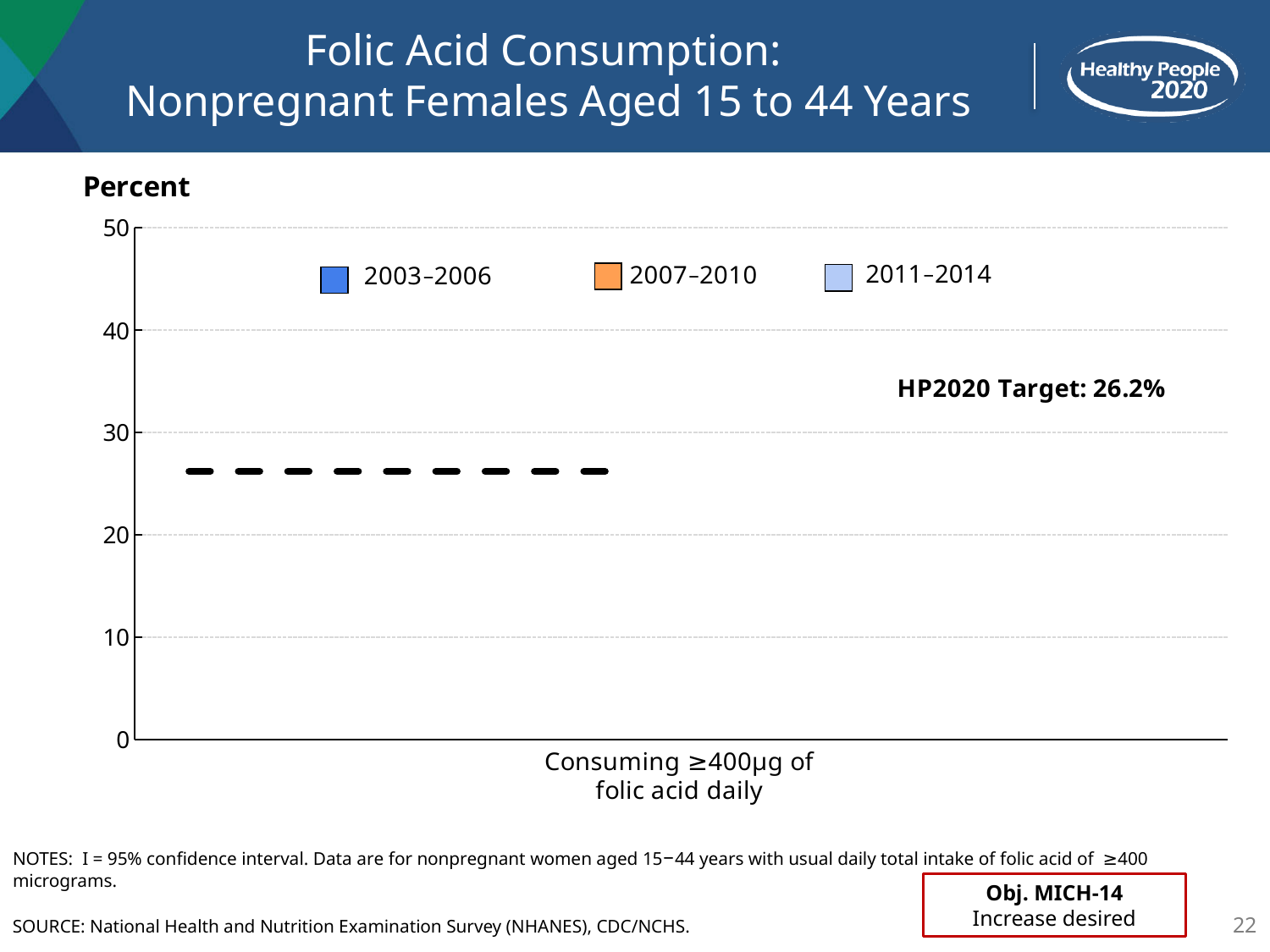
What is the maximum value shown on the y axis? 50 Is the HP2020 Target line greater or less than 20? greater What is the HP2020 Target value shown on the chart? 26.2% What is the label of the category on the x axis? Consuming ≥400µg of folic acid daily What are the three series named in the legend? 2003–2006, 2007–2010, 2011–2014 What is the label of the y axis? Percent How many series does the legend list? 3 Which objective number is shown on the slide? Obj. MICH-14 How many categories are shown on the x axis? 1 Is the HP2020 Target line above or below 30 on the y axis? below What is the title of the chart? Folic Acid Consumption: Nonpregnant Females Aged 15 to 44 Years